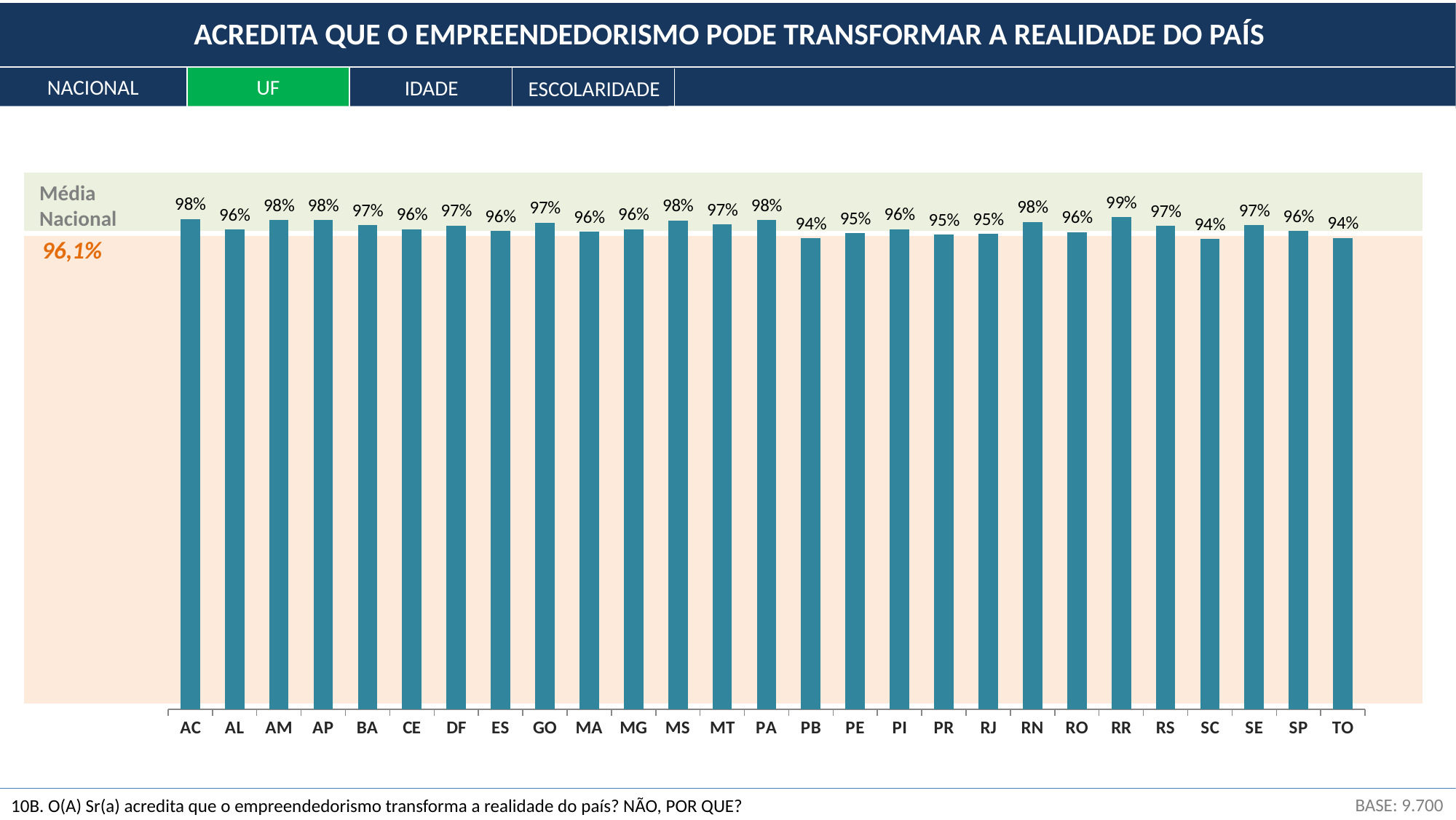
What is the value for BA? 97% Which is larger, the value for PR or the value for AM? AM What is the difference between the values for RR and TO? 5% What kind of chart is shown on the slide? bar chart What is the value for PB? 94% What is the value for RR? 99% What is the difference between the values for AC and PE? 3% Which state has the highest value? RR Which is larger, the value for MS or the value for SC? MS How many states are shown on the x axis? 27 What is the value for SP? 96% What is the Média Nacional value shown on the chart? 96,1%